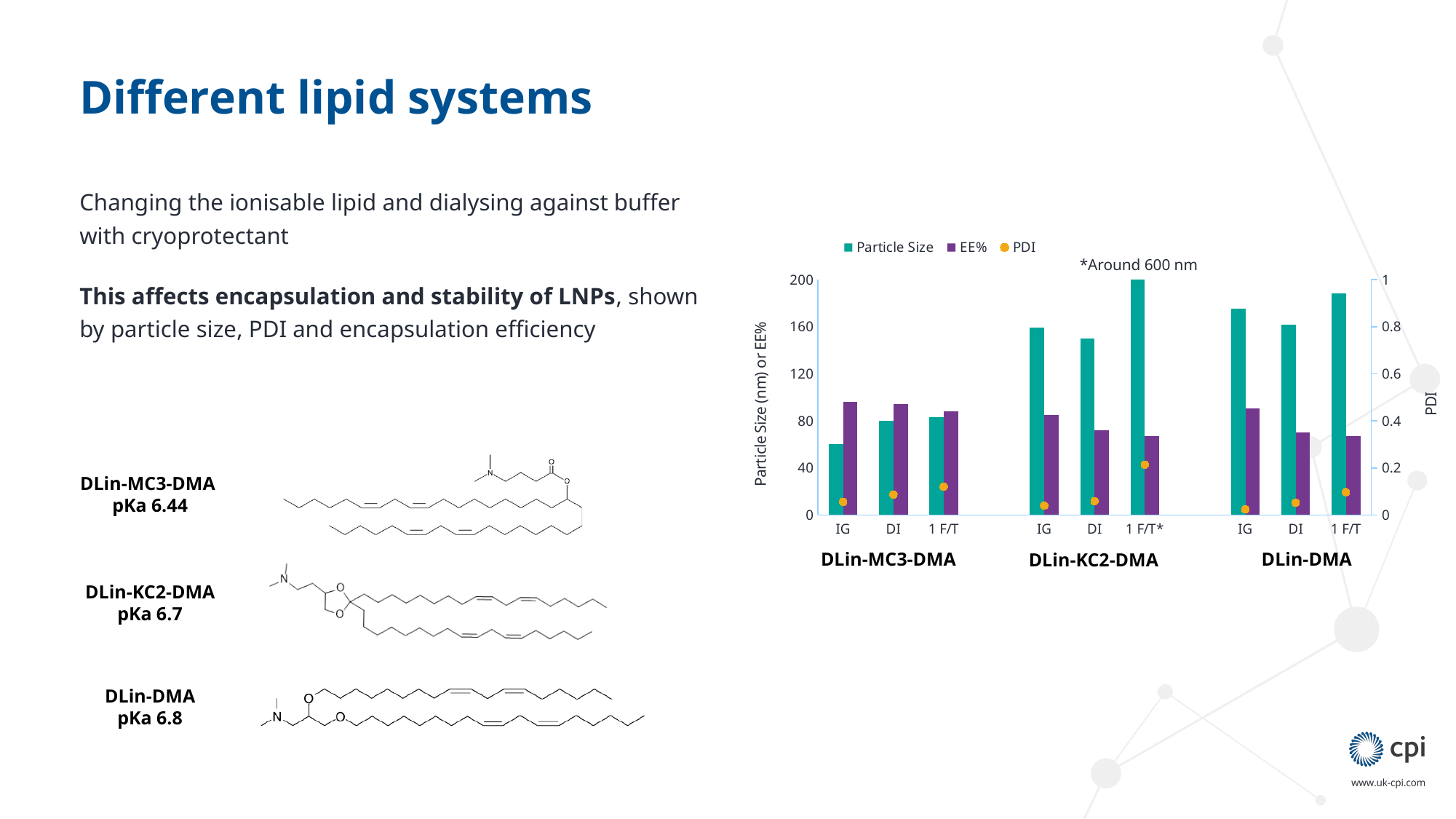
Which category has the shortest Particle Size bar? DLin-MC3-DMA IG What kind of chart is shown on the slide? bar chart Is the Particle Size value for DLin-KC2-DMA IG greater or less than 120? greater Is the PDI value for DLin-KC2-DMA 1 F/T* greater or less than 0.4? less Is the EE% value for DLin-MC3-DMA IG greater or less than 80? greater Do the Particle Size bars for DLin-MC3-DMA rise or fall from IG to 1 F/T? rise Which category has the tallest Particle Size bar? DLin-KC2-DMA 1 F/T* What does the annotation above the chart say the asterisked bar's value is? *Around 600 nm How many series does the chart legend list? 3 Which has the larger Particle Size bar: DLin-KC2-DMA IG or DLin-MC3-DMA IG? DLin-KC2-DMA IG How many categories (bar groups) are plotted along the x axis of the chart? 9